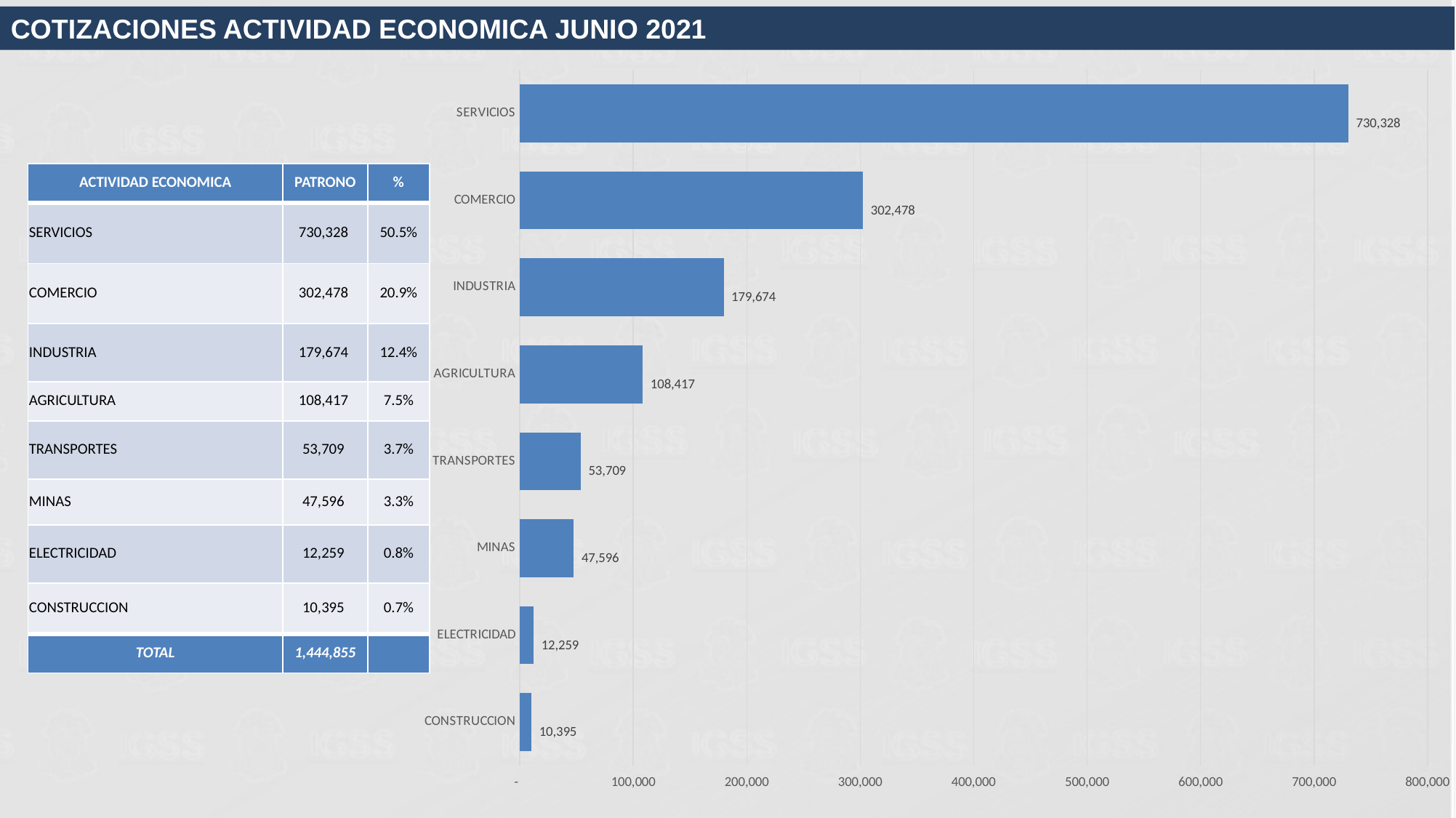
How many categories are shown in the bar chart? 8 What is the title of the slide containing the chart? COTIZACIONES ACTIVIDAD ECONOMICA JUNIO 2021 What is the difference between the values for TRANSPORTES and MINAS? 6,113 Is the value for COMERCIO greater or less than 300,000? greater Which category has the highest value in the bar chart? SERVICIOS Which is larger, the value for INDUSTRIA or the value for AGRICULTURA? INDUSTRIA Which category has the lowest value in the bar chart? CONSTRUCCION What kind of chart is shown on the slide? bar chart What is the value for SERVICIOS in the bar chart? 730,328 What is the value for AGRICULTURA in the bar chart? 108,417 What is the value for ELECTRICIDAD in the bar chart? 12,259 What is the difference between the values for COMERCIO and INDUSTRIA? 122,804